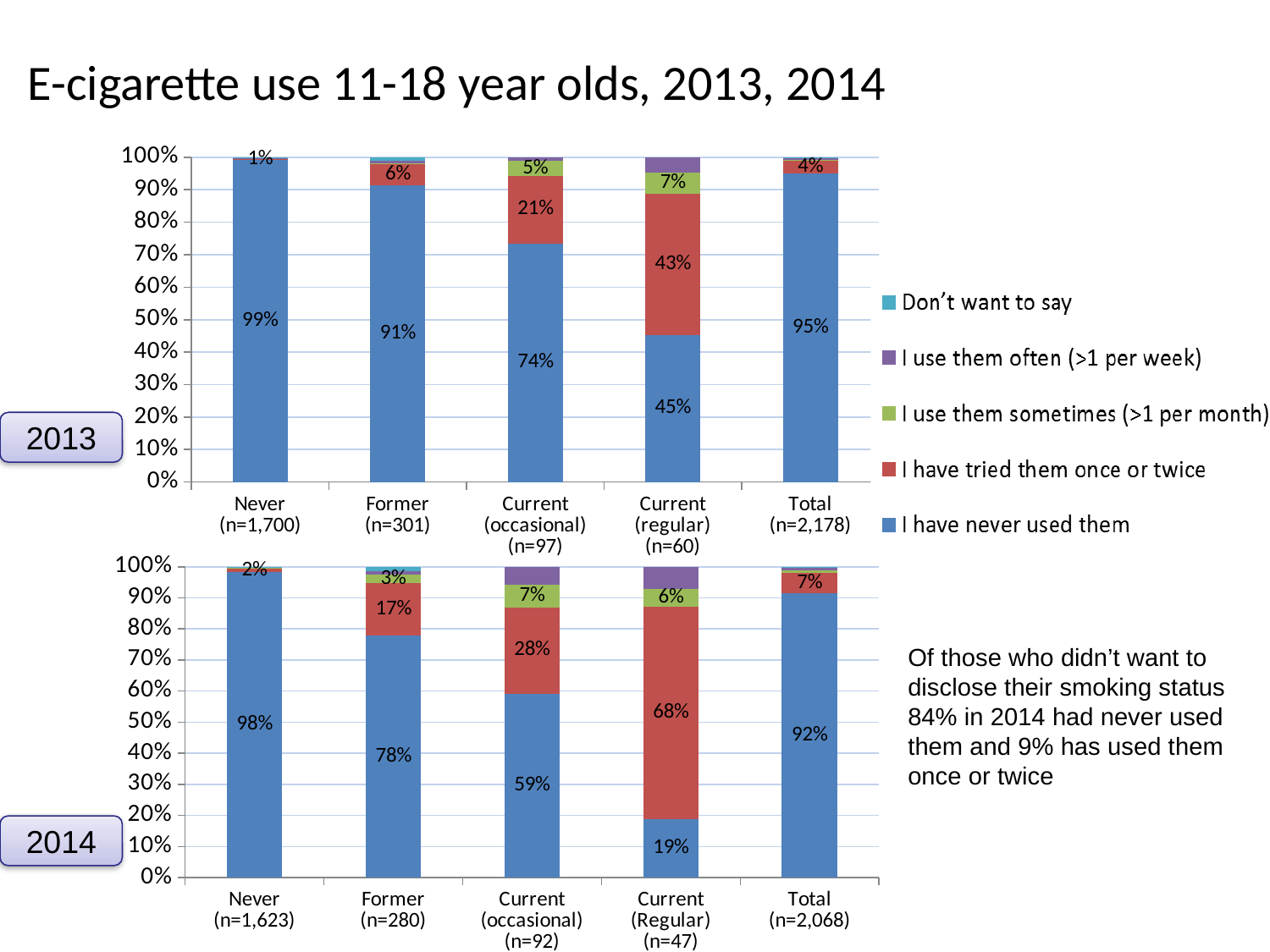
In the 2014 chart, which has a larger 'I have never used them' share: Former or Current (occasional)? Former In the 2013 chart, which category has the lowest 'I have never used them' share? Current (regular) In the 2014 chart, what percentage of the Current (Regular) group had tried e-cigarettes once or twice? 68% In the 2014 chart, which category has the highest 'I have tried them once or twice' share? Current (Regular) In the 2013 chart, is the 'I use them often (>1 per week)' value for Current (regular) greater or less than 10%? less What type of chart is used for the 2013 and 2014 data? Stacked bar chart In the 2014 chart, what is the 'I have never used them' value for the Total group? 92% In the 2013 chart, what percentage of the Current (regular) group had never used e-cigarettes? 45% In the 2013 chart, what is the 'I have tried them once or twice' value for the Former group? 6% How many series does the legend list? 5 In the 2013 chart, what is the difference in the 'I have never used them' share between the Never group and the Current (regular) group? 54 percentage points How many categories are shown on the x axis of the 2014 chart? 5